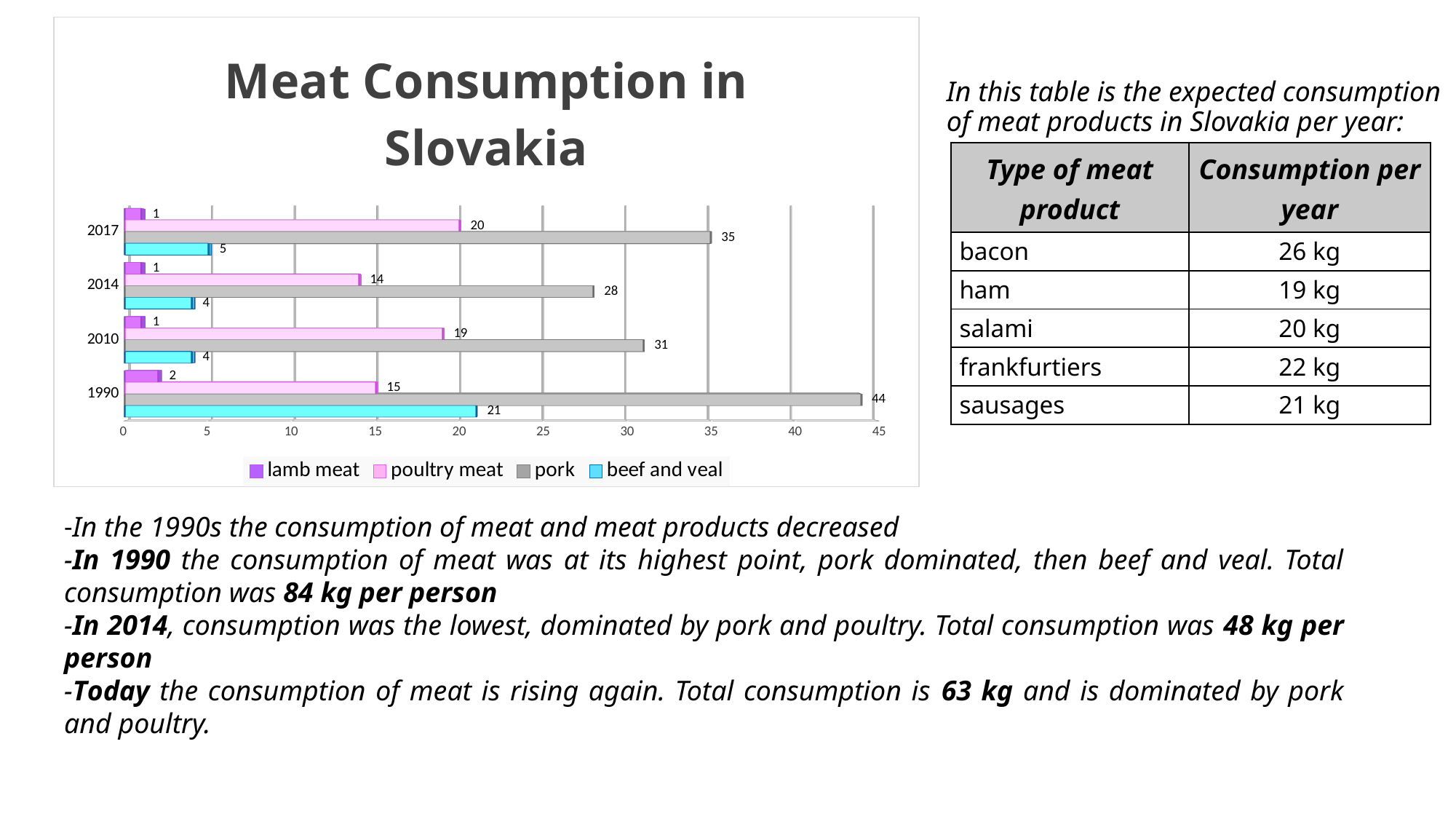
What is the title of the chart? Meat Consumption in Slovakia What is the lamb meat value for 1990? 2 How many series does the legend list? 4 How many years are shown on the chart? 4 In which year is the pork value highest? 1990 In which year is the pork value lowest? 2014 Which is larger, the poultry meat value for 2010 or for 2014? 2010 What kind of chart is shown on the slide? bar chart What is the poultry meat value for 2017? 20 What is the pork value for 1990 in the Meat Consumption in Slovakia chart? 44 What is the difference between the pork values for 1990 and 2017? 9 What is the beef and veal value for 2014? 4